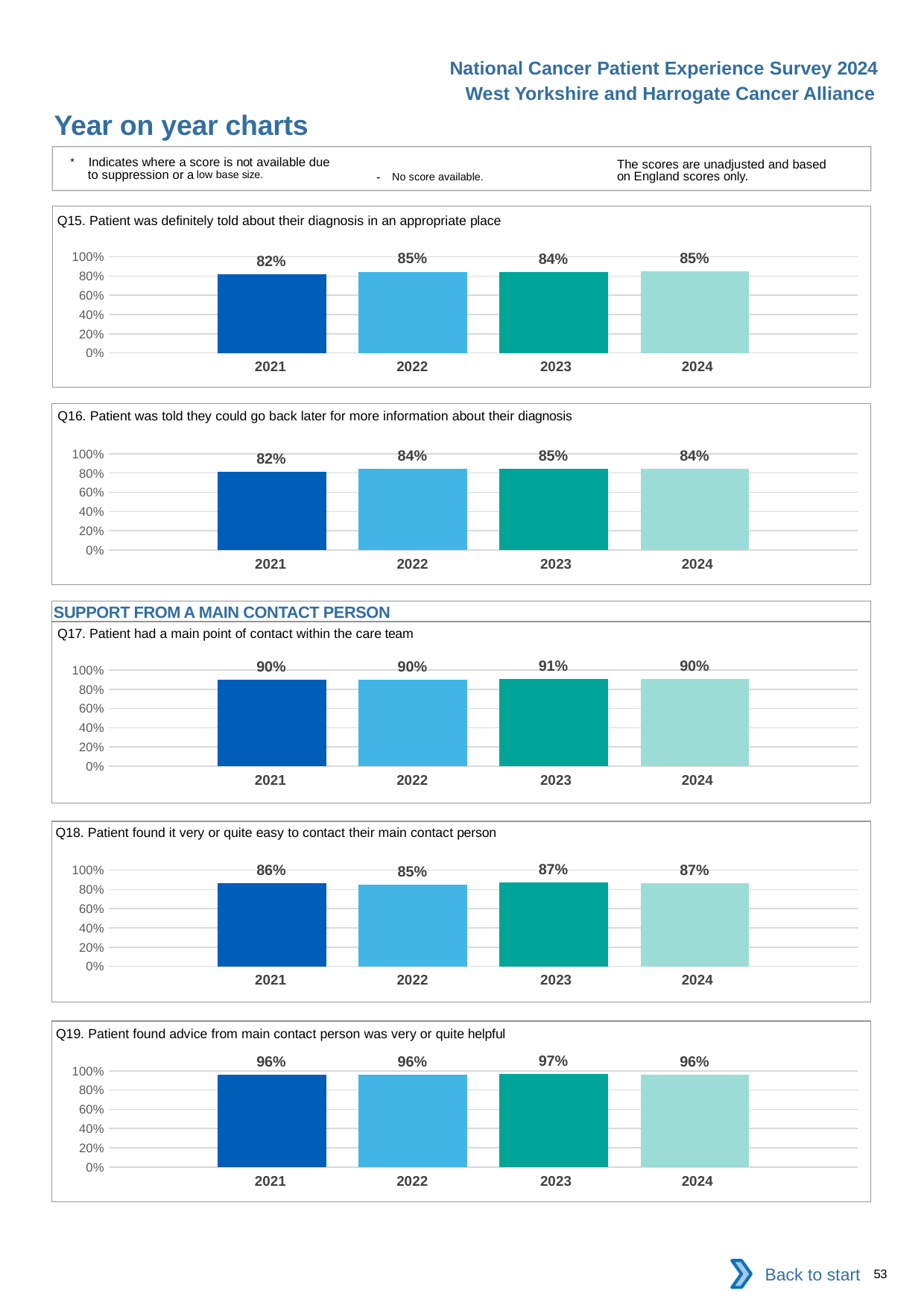
In the Q15 chart, what is the value for 2021? 82% What type of chart is used for Q16? bar chart In the Q16 chart, what is the value for 2024? 84% In the Q19 chart, which year has the highest value? 2023 In the Q19 chart, what is the value for 2021? 96% What is the section heading shown above the Q17 chart? SUPPORT FROM A MAIN CONTACT PERSON In the Q16 chart, which year has the highest value? 2023 In the Q17 chart, what is the value for 2023? 91% In the Q15 chart, is the value for 2022 larger or smaller than the value for 2023? larger In the Q18 chart, what is the difference between the 2023 value and the 2022 value? 2% In the Q18 chart, which year has the lowest value? 2022 In the Q15 chart, how many years are shown on the x axis? 4